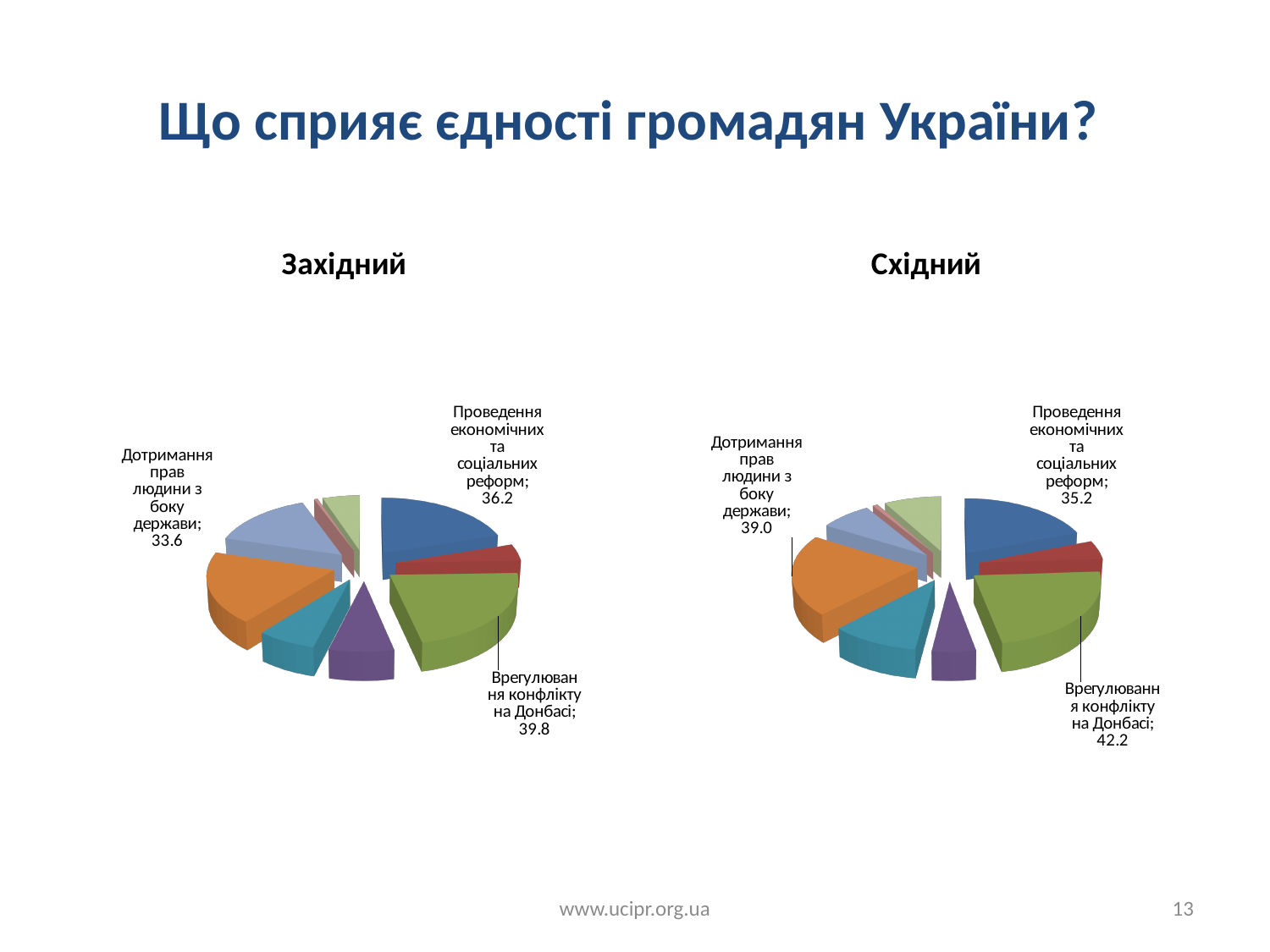
In the "Східний" chart, which of the labelled categories has the lowest value? Проведення економічних та соціальних реформ In the "Західний" chart, what is the difference between "Врегулювання конфлікту на Донбасі" and "Дотримання прав людини з боку держави"? 6.2 In the "Західний" chart, what is the value for "Дотримання прав людини з боку держави"? 33.6 In the "Західний" chart, what is the value for "Проведення економічних та соціальних реформ"? 36.2 Is the value for "Дотримання прав людини з боку держави" larger in the "Західний" chart or the "Східний" chart? Східний In the "Східний" chart, what is the difference between "Врегулювання конфлікту на Донбасі" and "Проведення економічних та соціальних реформ"? 7.0 What kind of chart is used for the "Західний" data? Pie chart In the "Східний" chart, what is the value for "Врегулювання конфлікту на Донбасі"? 42.2 In the "Східний" chart, what is the value for "Проведення економічних та соціальних реформ"? 35.2 In the "Західний" chart, what is the value for "Врегулювання конфлікту на Донбасі"? 39.8 In the "Західний" chart, which of the labelled categories has the highest value? Врегулювання конфлікту на Донбасі In the "Східний" chart, what is the value for "Дотримання прав людини з боку держави"? 39.0